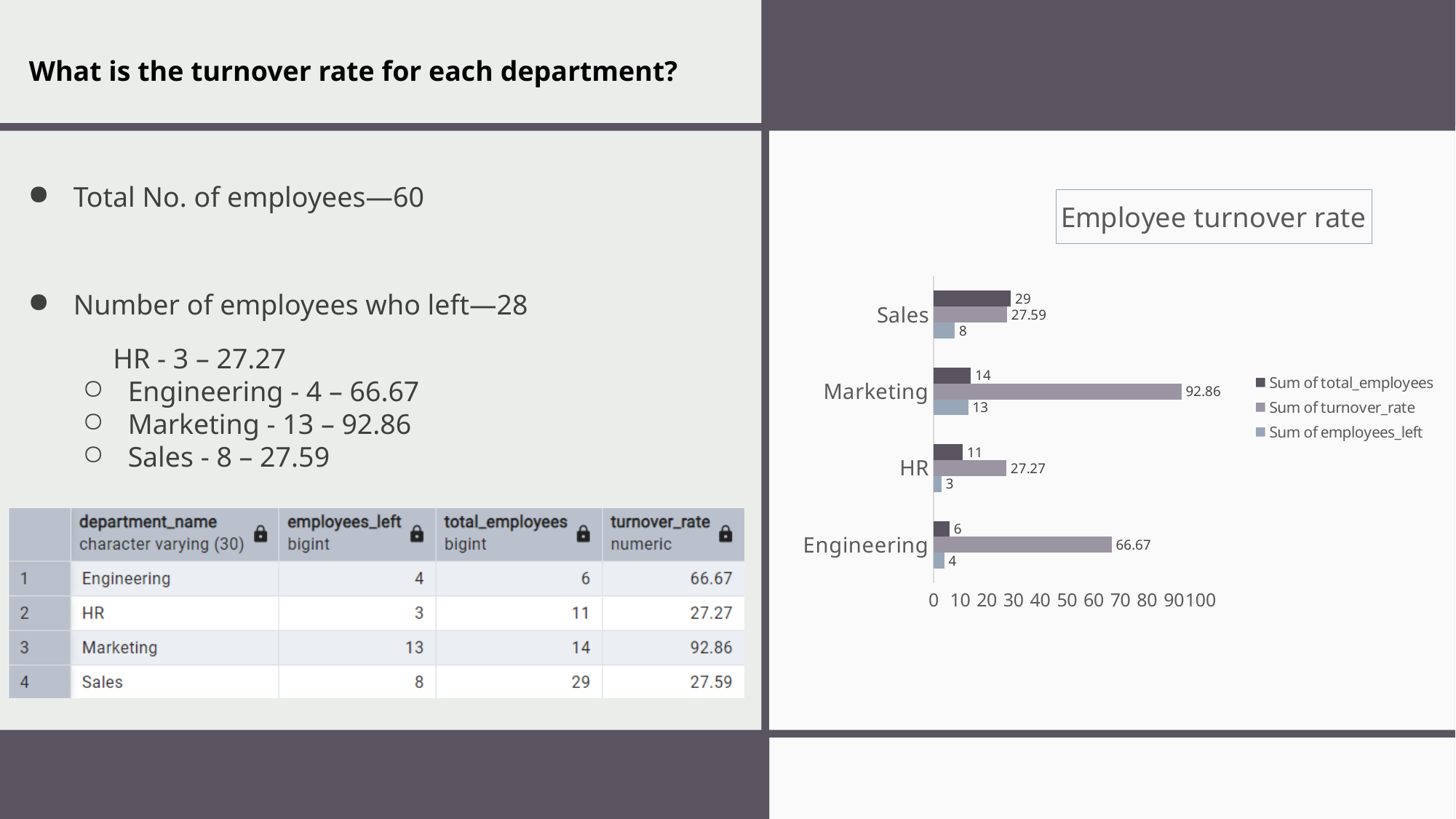
What is the title of the chart? Employee turnover rate How many series does the legend list? 3 What is the Sum of turnover_rate for Marketing? 92.86 What is the Sum of total_employees for Sales? 29 Which is larger, the Sum of turnover_rate for Engineering or for HR? Engineering What is the Sum of employees_left for HR? 3 How many departments are shown on the chart? 4 What is the difference between the Sum of total_employees for Sales and for Marketing? 15 What kind of chart is shown? bar chart Is the Sum of turnover_rate for Sales greater or less than 30? less Which department has the highest Sum of turnover_rate? Marketing Which department has the lowest Sum of total_employees? Engineering